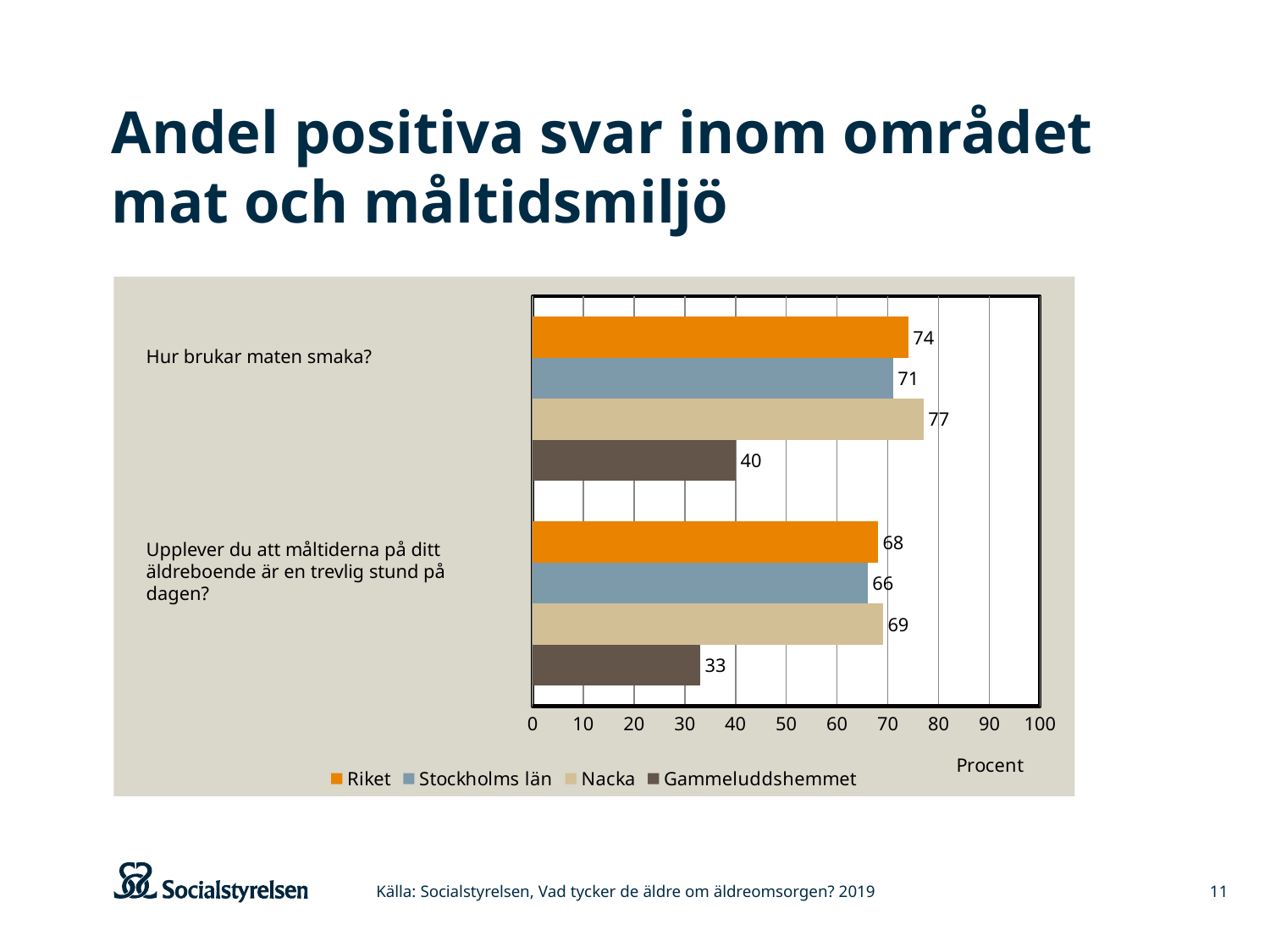
What is the label of the x axis? Procent Which series has the highest value for the question "Hur brukar maten smaka?"? Nacka What is the value for Nacka for the question "Hur brukar maten smaka?"? 77 What is the value for Stockholms län for the question "Upplever du att måltiderna på ditt äldreboende är en trevlig stund på dagen?"? 66 How many series does the legend list? 4 What is the value for Riket for the question "Hur brukar maten smaka?"? 74 Which is larger for the question "Upplever du att måltiderna på ditt äldreboende är en trevlig stund på dagen?": Riket or Nacka? Nacka What is the value for Gammeluddshemmet for the question "Upplever du att måltiderna på ditt äldreboende är en trevlig stund på dagen?"? 33 How many questions (categories) are shown on the chart? 2 Which series has the lowest value for the question "Upplever du att måltiderna på ditt äldreboende är en trevlig stund på dagen?"? Gammeluddshemmet What is the difference between the Nacka and Gammeluddshemmet values for the question "Hur brukar maten smaka?"? 37 What kind of chart is shown on the slide? Bar chart